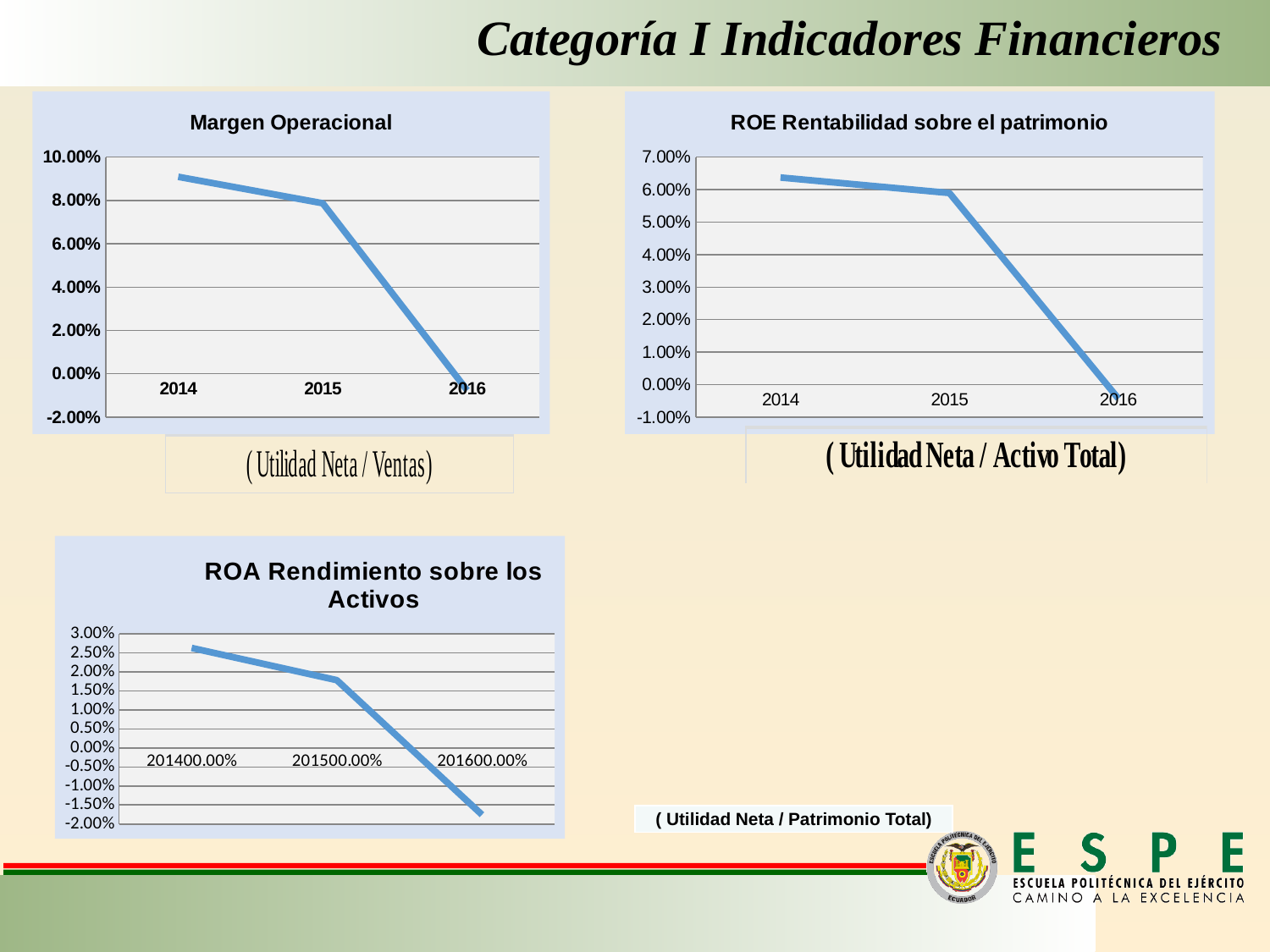
In the "ROE Rentabilidad sobre el patrimonio" chart, which is larger, the value for 2015 or the value for 2016? 2015 In the "Margen Operacional" chart, is the value for 2014 greater or less than 8.00%? greater How many charts are shown on the slide? 3 In the "Margen Operacional" chart, which year has the lowest value? 2016 In the "Margen Operacional" chart, which year has the highest value? 2014 In the "ROA Rendimiento sobre los Activos" chart, is the first value (2014) greater or less than 2.50%? greater How many data points are plotted in the "ROE Rentabilidad sobre el patrimonio" chart? 3 In the "ROE Rentabilidad sobre el patrimonio" chart, do the values rise or fall from 2014 to 2016? fall In the "ROE Rentabilidad sobre el patrimonio" chart, is the value for 2014 greater or less than 6.00%? greater What kind of chart is the "Margen Operacional" chart? line chart